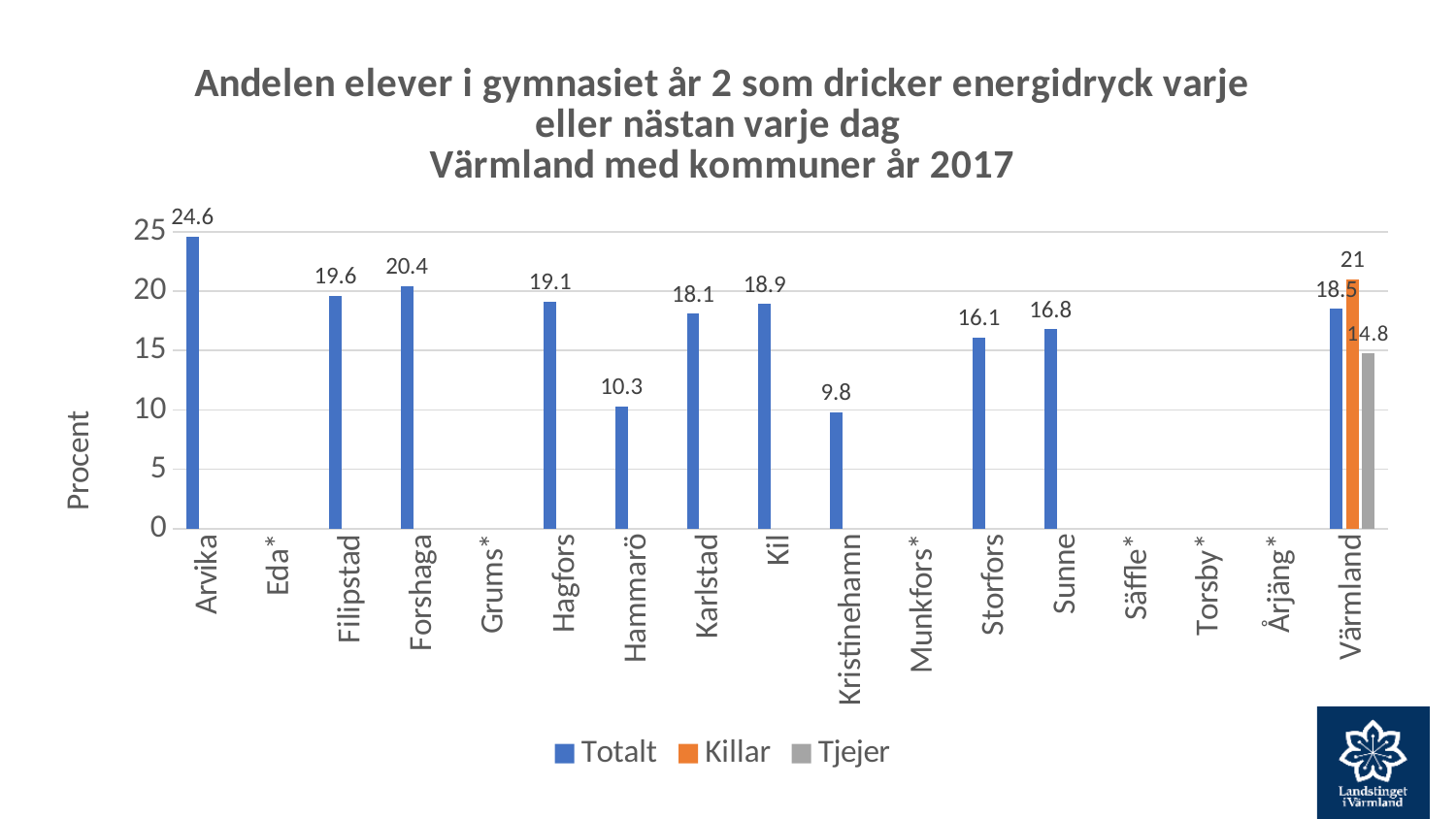
What is the Tjejer value for Värmland? 14.8 What kind of chart is shown on the slide? Bar chart How many series does the legend list? 3 What is the difference between the Totalt values for Forshaga and Filipstad? 0.8 Which has a higher Totalt value, Sunne or Storfors? Sunne What is the Killar value for Värmland? 21 What is the Totalt value for Hammarö? 10.3 What is the difference between the Killar and Tjejer values for Värmland? 6.2 Which municipality has the highest Totalt value? Arvika What is the Totalt value for Arvika? 24.6 Which municipality with a plotted bar has the lowest Totalt value? Kristinehamn What colour represents the Killar series? Orange